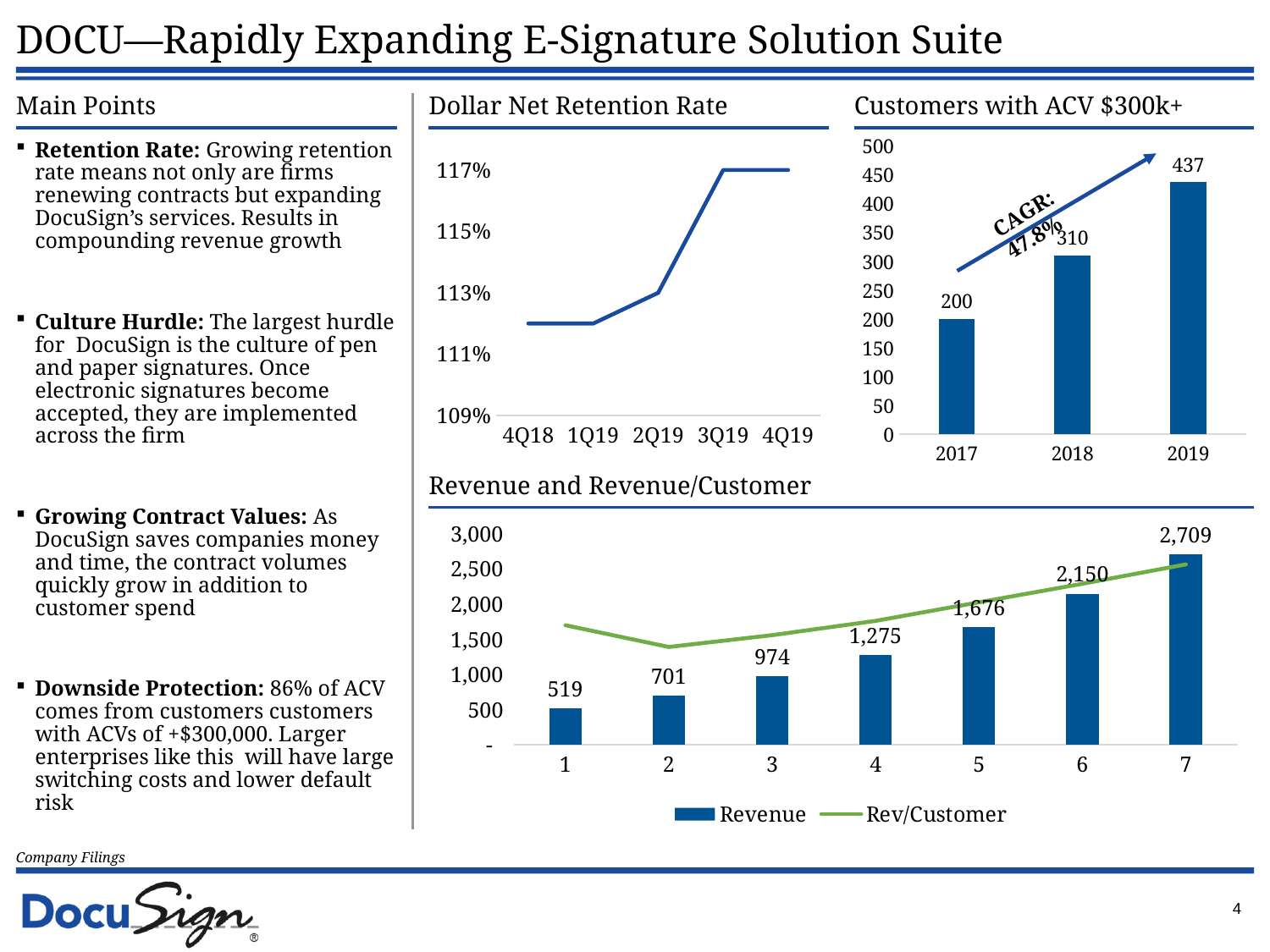
In the Revenue and Revenue/Customer chart, what is the Revenue value for category 7? 2,709 In the Customers with ACV $300k+ chart, what is the value for 2017? 200 In the Revenue and Revenue/Customer chart, what is the difference in Revenue between category 6 and category 5? 474 In the Customers with ACV $300k+ chart, what is the difference between the 2019 and 2018 values? 127 In the Revenue and Revenue/Customer chart, how many categories are shown on the x axis? 7 In the Revenue and Revenue/Customer chart, what is the Revenue value for category 4? 1,275 In the Customers with ACV $300k+ chart, what is the value for 2019? 437 In the Dollar Net Retention Rate chart, do the values generally rise or fall from 4Q18 to 4Q19? rise In the Dollar Net Retention Rate chart, is the value for 4Q18 greater or less than 113%? less In the Revenue and Revenue/Customer chart, which category has the lowest Revenue? 1 In the Revenue and Revenue/Customer chart, how many series does the legend list? 2 In the Customers with ACV $300k+ chart, what CAGR is shown? 47.8%